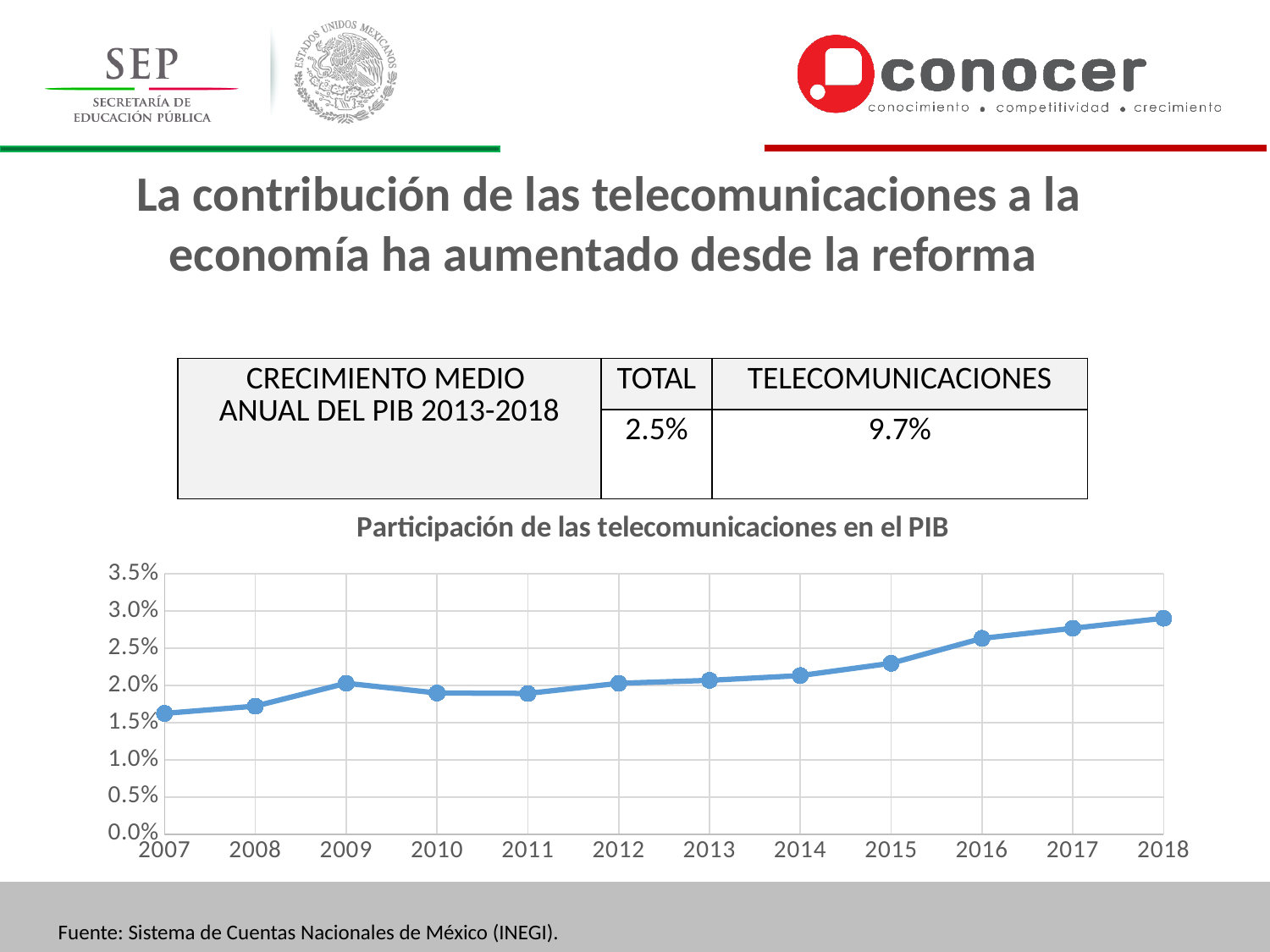
What kind of chart is shown on the slide? line chart Do the values generally rise or fall from 2007 to 2018? rise Is the value for 2012 greater or less than 2.5%? less Is the value for 2018 greater or less than 2.5%? greater Is the value for 2015 greater or less than 2.0%? greater Which year has the highest value on the chart? 2018 Which is larger, the value for 2016 or the value for 2012? 2016 How many years are plotted on the chart? 12 What is the highest value shown on the vertical axis? 3.5% Which year has the lowest value on the chart? 2007 What is the title of the chart? Participación de las telecomunicaciones en el PIB